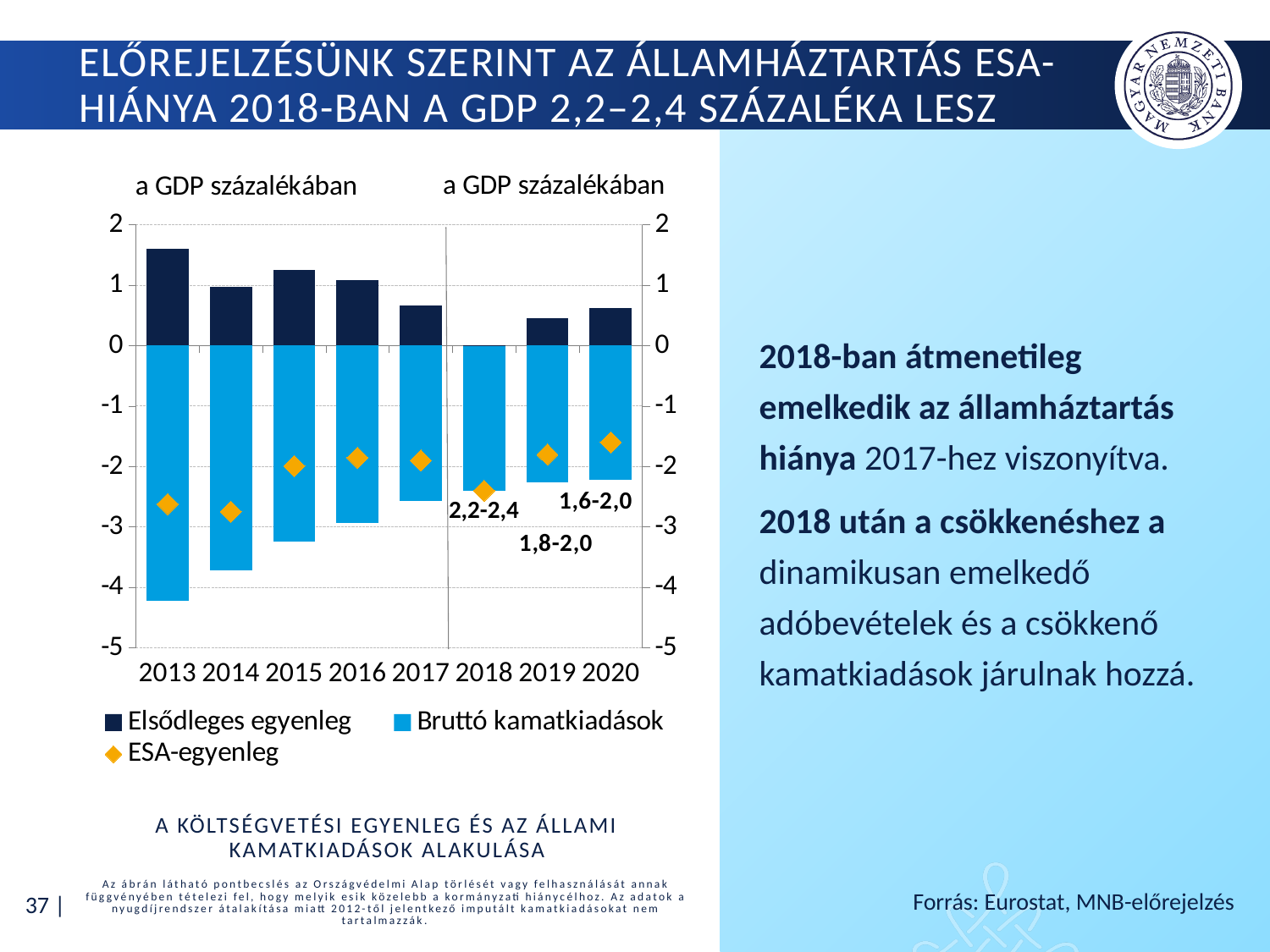
How many series does the chart legend list? 3 Is the Elsődleges egyenleg value for 2013 greater or less than 1? greater In which year is the Bruttó kamatkiadások bar the lowest (most negative)? 2013 What is the data label shown for 2020 in the chart? 1,6-2,0 Which year has the larger Elsődleges egyenleg value, 2015 or 2017? 2015 How many years are shown on the x axis of the chart? 8 What is the axis title shown above the vertical axes of the chart? a GDP százalékában In which year is the Elsődleges egyenleg bar the highest? 2013 What is the data label shown for 2019 in the chart? 1,8-2,0 What is the data label shown for 2018 in the chart? 2,2-2,4 What kind of chart is shown on the slide? bar chart Is the Bruttó kamatkiadások value for 2013 greater or less than -4? less